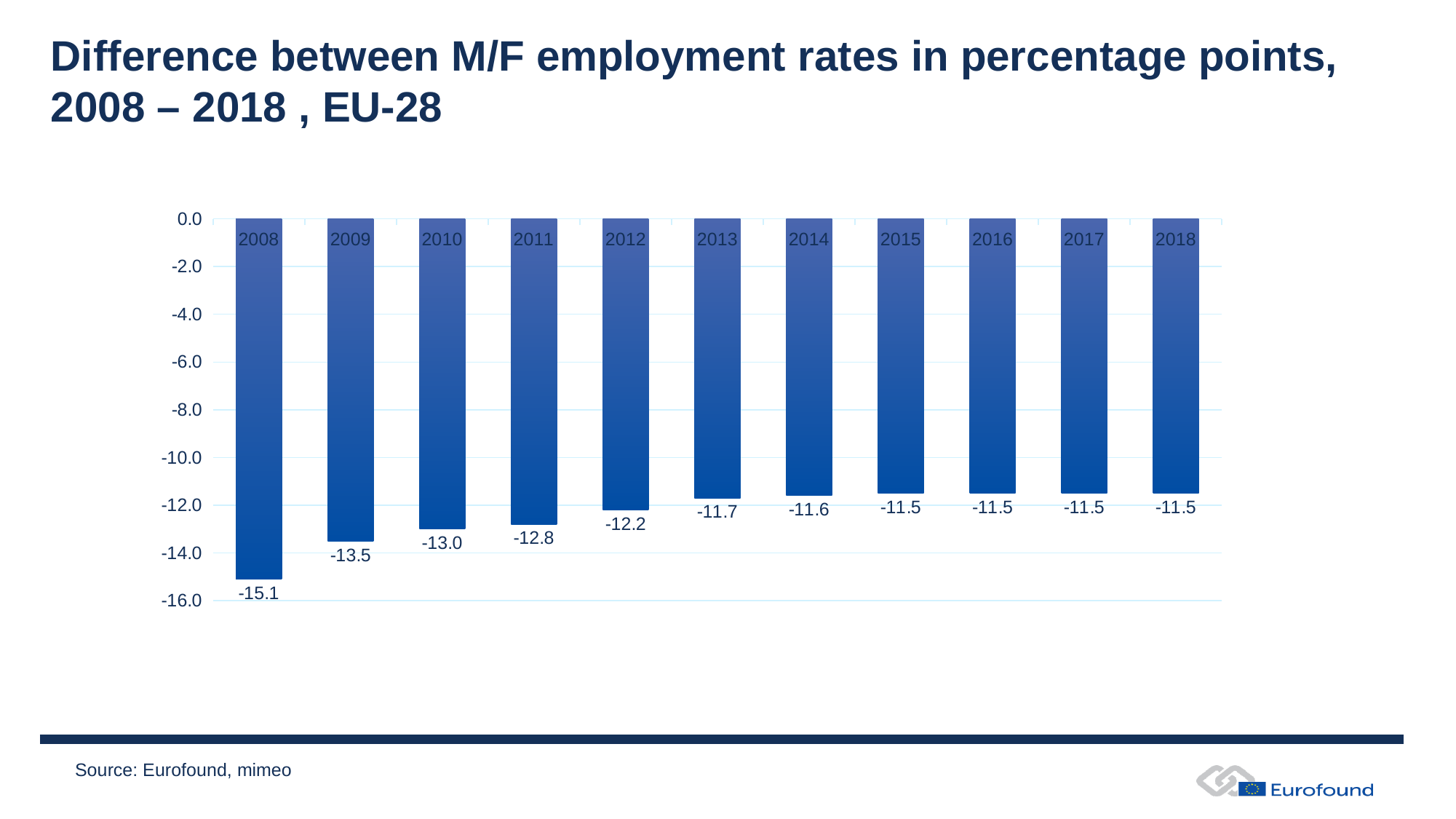
Which year has the lowest (most negative) value? 2008 What is the value for 2010? -13.0 What is the difference between the values for 2008 and 2018? 3.6 What is the difference between the values for 2009 and 2011? 0.7 Which is larger, the value for 2013 or the value for 2009? 2013 How many years are shown on the chart? 11 Do the values rise or fall from 2008 to 2018? rise Is the value for 2008 greater or less than -14.0? less What is the value for 2018? -11.5 What kind of chart is shown on the slide? bar chart What is the value for 2008? -15.1 What is the value for 2012? -12.2